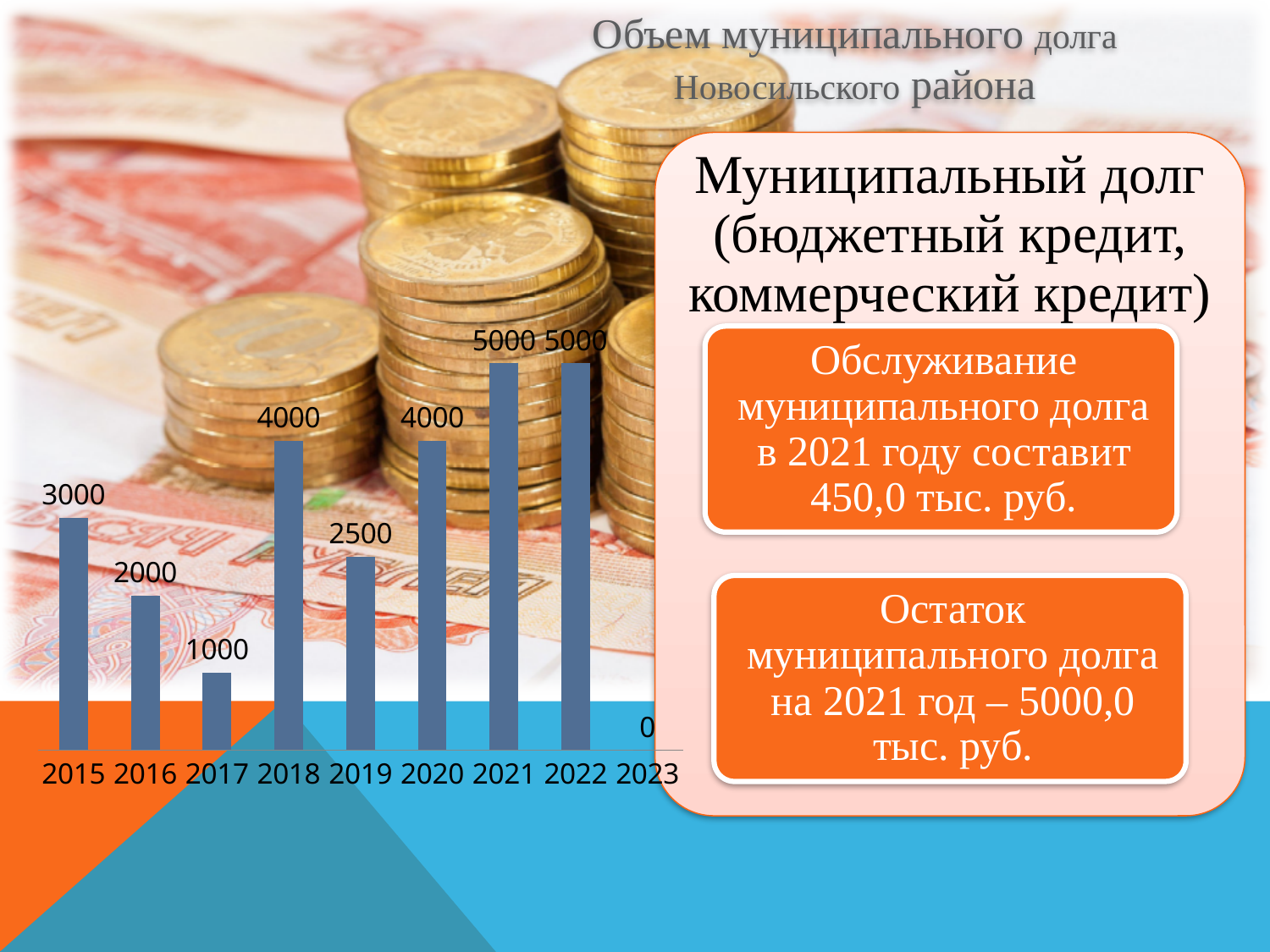
How many years are shown on the x axis? 9 What is the value for 2015? 3000 What kind of chart is shown? bar chart What is the difference between the values for 2021 and 2019? 2500 Which is larger, the value for 2016 or the value for 2019? 2019 Which year has the lowest value? 2023 Do the values rise or fall from 2015 to 2017? fall What is the difference between the values for 2018 and 2017? 3000 What is the value for 2019? 2500 What is the value for 2023? 0 Which is larger, the value for 2015 or the value for 2017? 2015